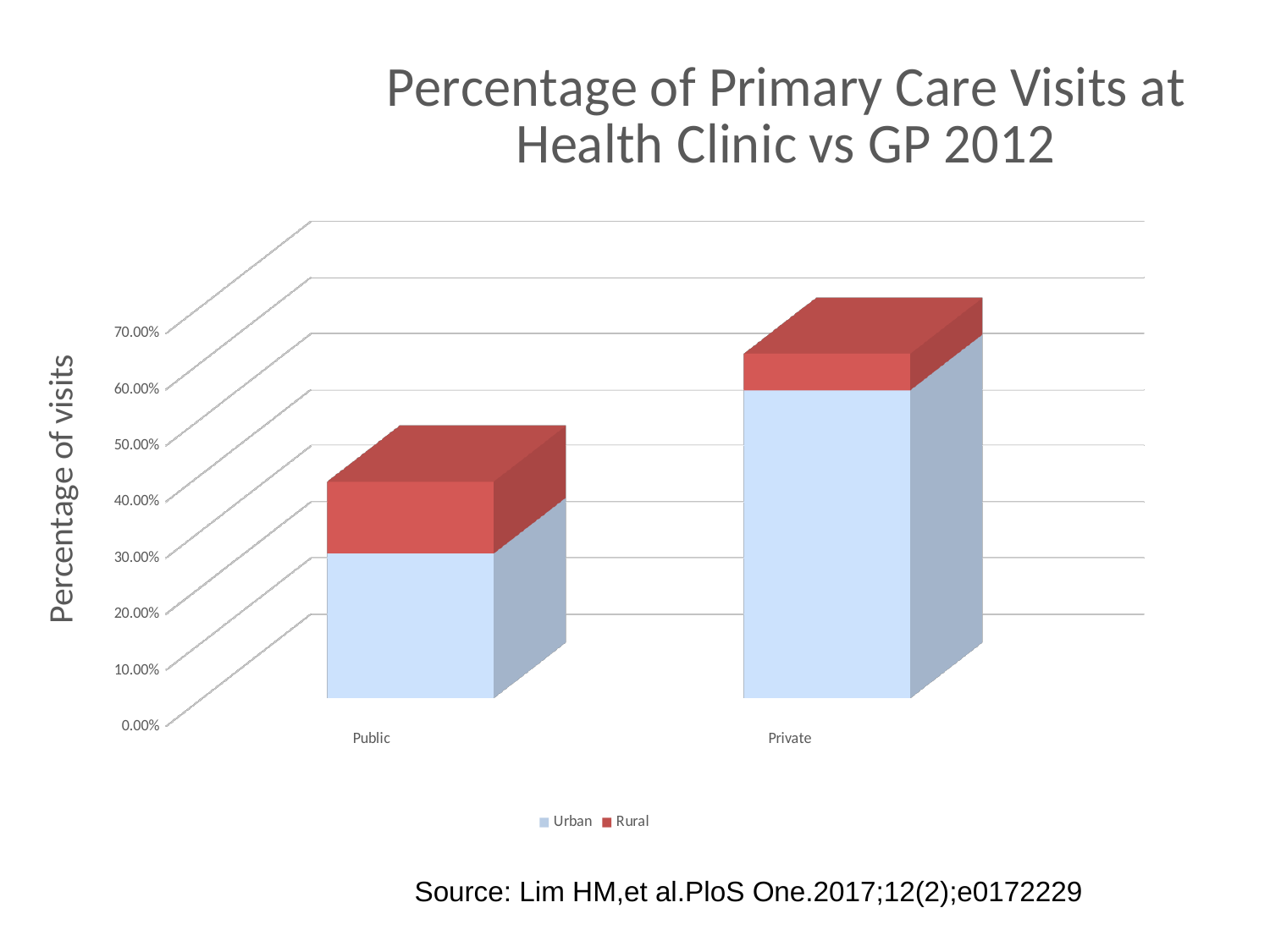
Which category has the taller stacked bar overall, Public or Private? Private What is the title of the chart? Percentage of Primary Care Visits at Health Clinic vs GP 2012 Which is larger, the Rural value for Public or the Rural value for Private? Public Which is larger, the Urban value for Public or the Urban value for Private? Private Is the Urban value for Public greater or less than 40%? less How many series does the legend list? 2 How many categories are shown on the x axis? 2 Which category has the shorter stacked bar overall? Public Which series are listed in the legend? Urban and Rural What kind of chart is shown on the slide? stacked bar chart Is the Urban value for Private greater or less than 50%? greater